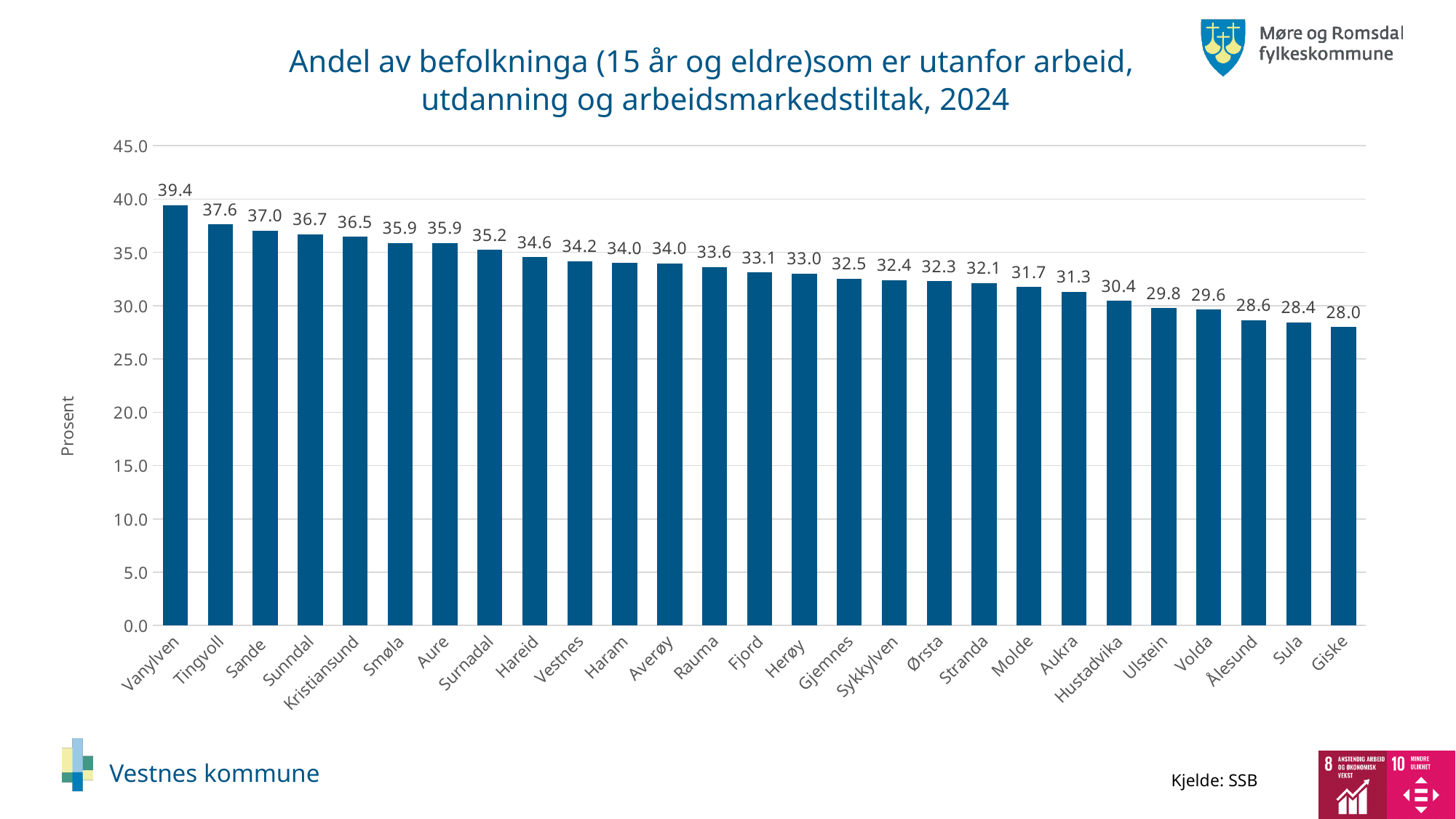
What is the difference between the values for Tingvoll and Ålesund? 9.0 Which has a larger value, Sunndal or Hustadvika? Sunndal What is the value for Kristiansund? 36.5 What is the difference between the values for Vanylven and Giske? 11.4 Which municipality has the highest value? Vanylven What is the label on the vertical axis? Prosent Which municipality has the lowest value? Giske Is the value for Ulstein greater or less than 30.0? less What is the value for Vestnes? 34.2 What is the value for Molde? 31.7 What kind of chart is shown on the slide? Bar chart How many municipalities are shown on the chart? 27